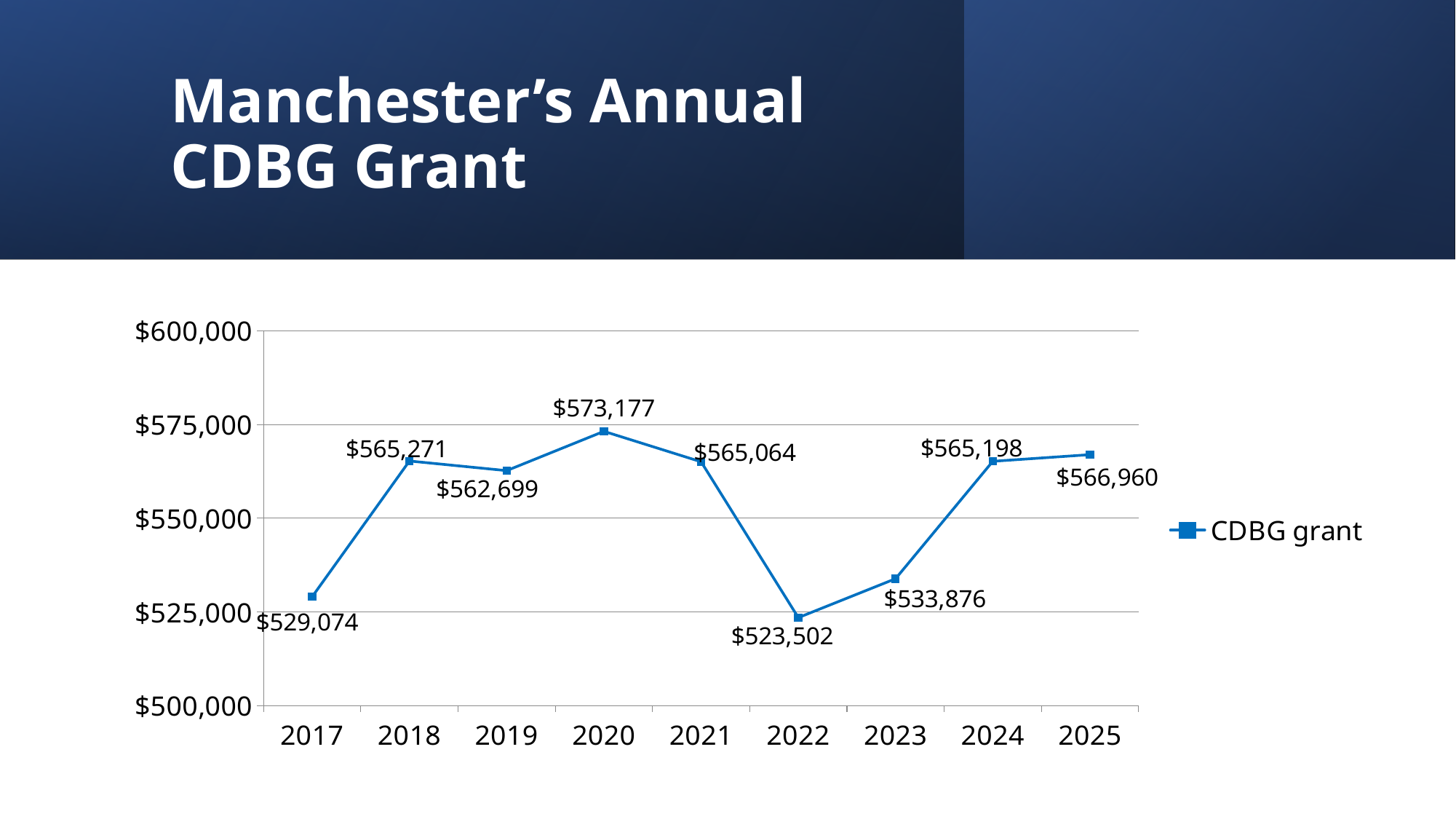
What was Manchester's CDBG grant in 2020? $573,177 Which year had the highest CDBG grant? 2020 What is the difference between the CDBG grant in 2020 and in 2022? $49,675 Which year had the lowest CDBG grant? 2022 What type of chart is shown on the slide? line chart How many years are plotted on the chart? 9 Is the CDBG grant value for 2017 greater or less than $550,000? less Did the CDBG grant rise or fall from 2021 to 2022? fall What was the CDBG grant in 2023? $533,876 By how much did the CDBG grant increase from 2017 to 2018? $36,197 What was the CDBG grant value for 2017? $529,074 Which year had a larger CDBG grant, 2017 or 2023? 2023